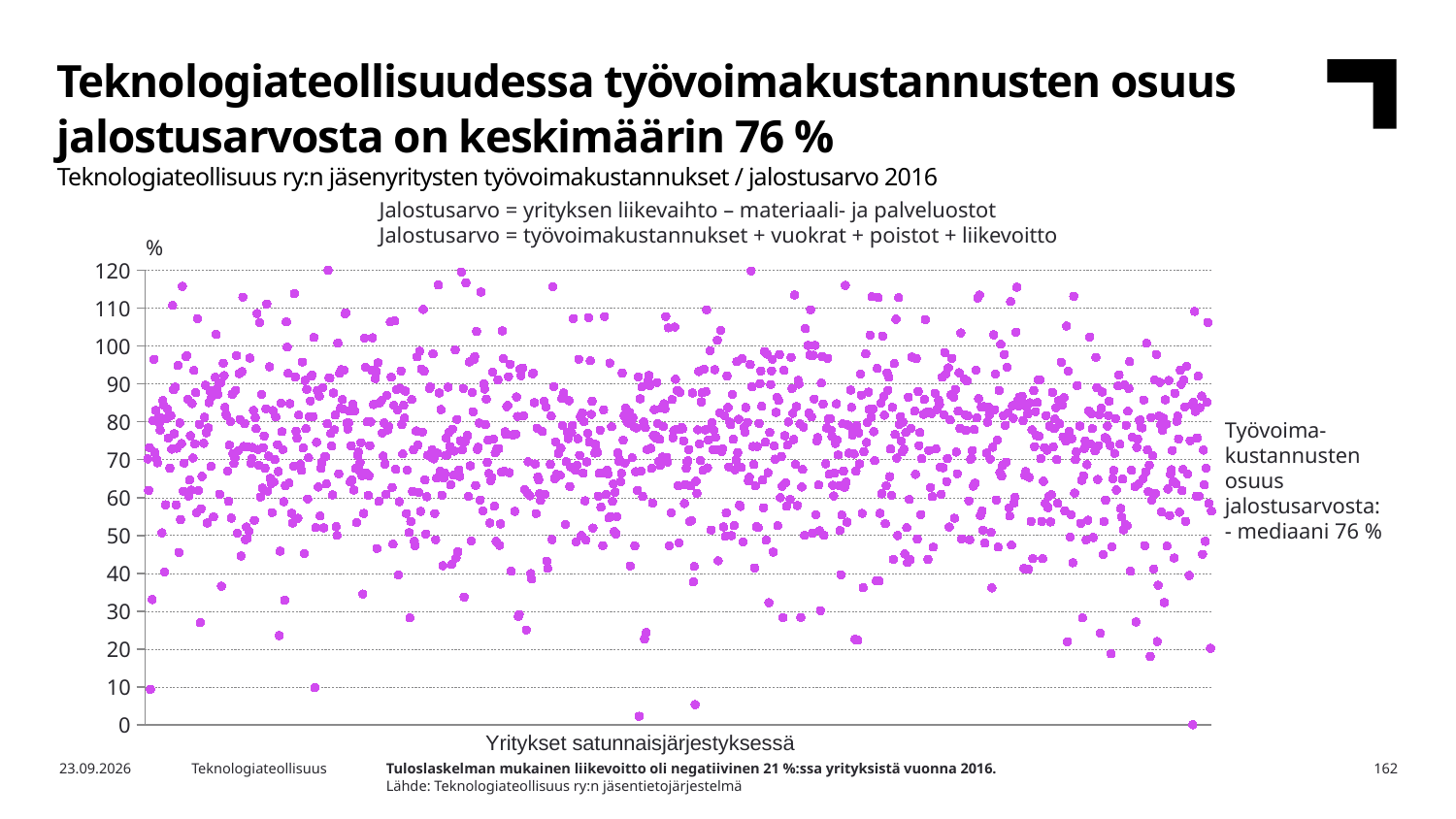
Which year's data does the chart show? 2016 According to the annotation on the right of the chart, what is the median share of labour costs in value added? 76 % According to the footnote, in what share of companies was the operating profit negative in 2016? 21 % What kind of chart is shown on the slide? scatter chart What is the label of the horizontal axis? Yritykset satunnaisjärjestyksessä What unit is shown at the top of the vertical axis? %